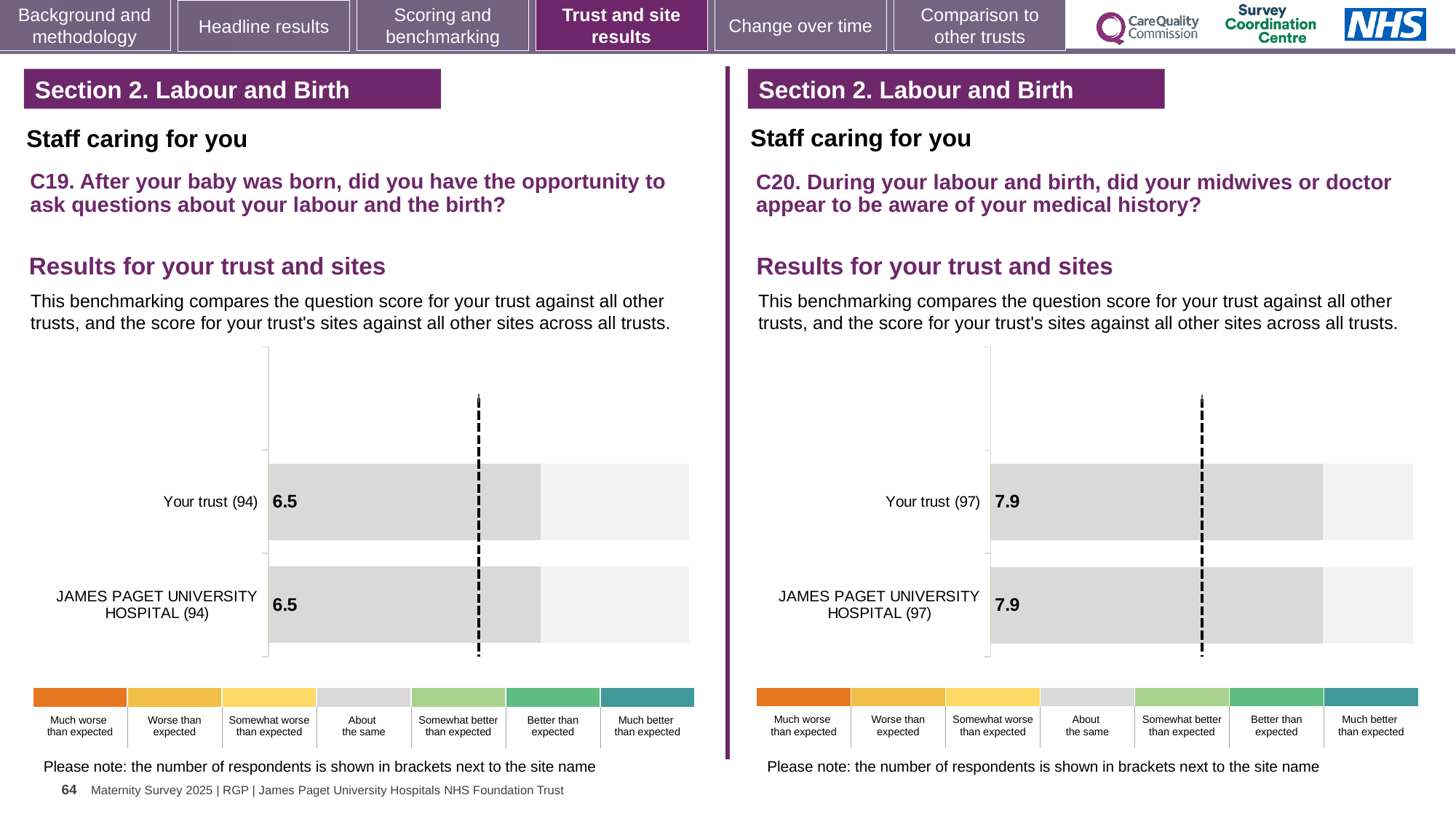
On the left chart (C19), how many respondents are shown in brackets next to Your trust? 94 On the left chart (C19), what is the score for JAMES PAGET UNIVERSITY HOSPITAL? 6.5 On the right chart (C20), what is the difference between the score for Your trust and the score for JAMES PAGET UNIVERSITY HOSPITAL? 0 On the right chart (C20), what is the score for JAMES PAGET UNIVERSITY HOSPITAL? 7.9 On the right chart (C20), how many respondents are shown in brackets next to JAMES PAGET UNIVERSITY HOSPITAL? 97 On the right chart (C20), what is the score for Your trust? 7.9 What kind of chart is used on the left (C19)? Bar chart What kind of chart is used on the right (C20)? Bar chart On the left chart (C19), what is the score for Your trust? 6.5 On the left chart (C19), what is the difference between the score for Your trust and the score for JAMES PAGET UNIVERSITY HOSPITAL? 0 How many bars are plotted on the right chart (C20)? 2 How many bars are plotted on the left chart (C19)? 2